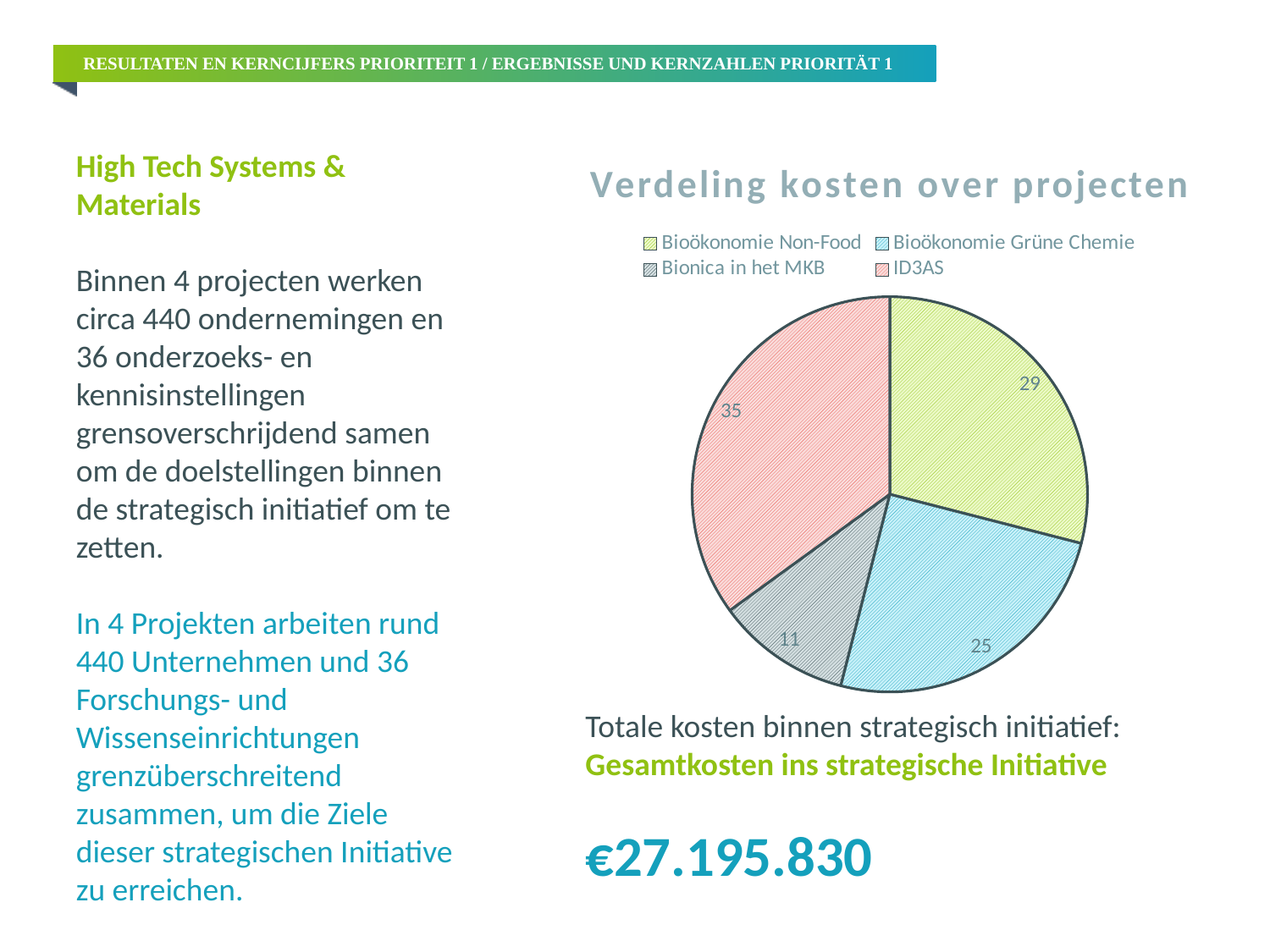
What type of chart is shown on the slide? pie chart What is the difference between the values for ID3AS and Bionica in het MKB? 24 Which is larger, the value for Bioökonomie Non-Food or Bioökonomie Grüne Chemie? Bioökonomie Non-Food What is the value for ID3AS? 35 Which project has the smallest slice? Bionica in het MKB How many entries does the legend list? 4 What is the title of the chart? Verdeling kosten over projecten What is the value for Bionica in het MKB? 11 What is the value for Bioökonomie Non-Food? 29 What is the value for Bioökonomie Grüne Chemie? 25 Which project has the largest slice? ID3AS How many slices does the pie chart have? 4